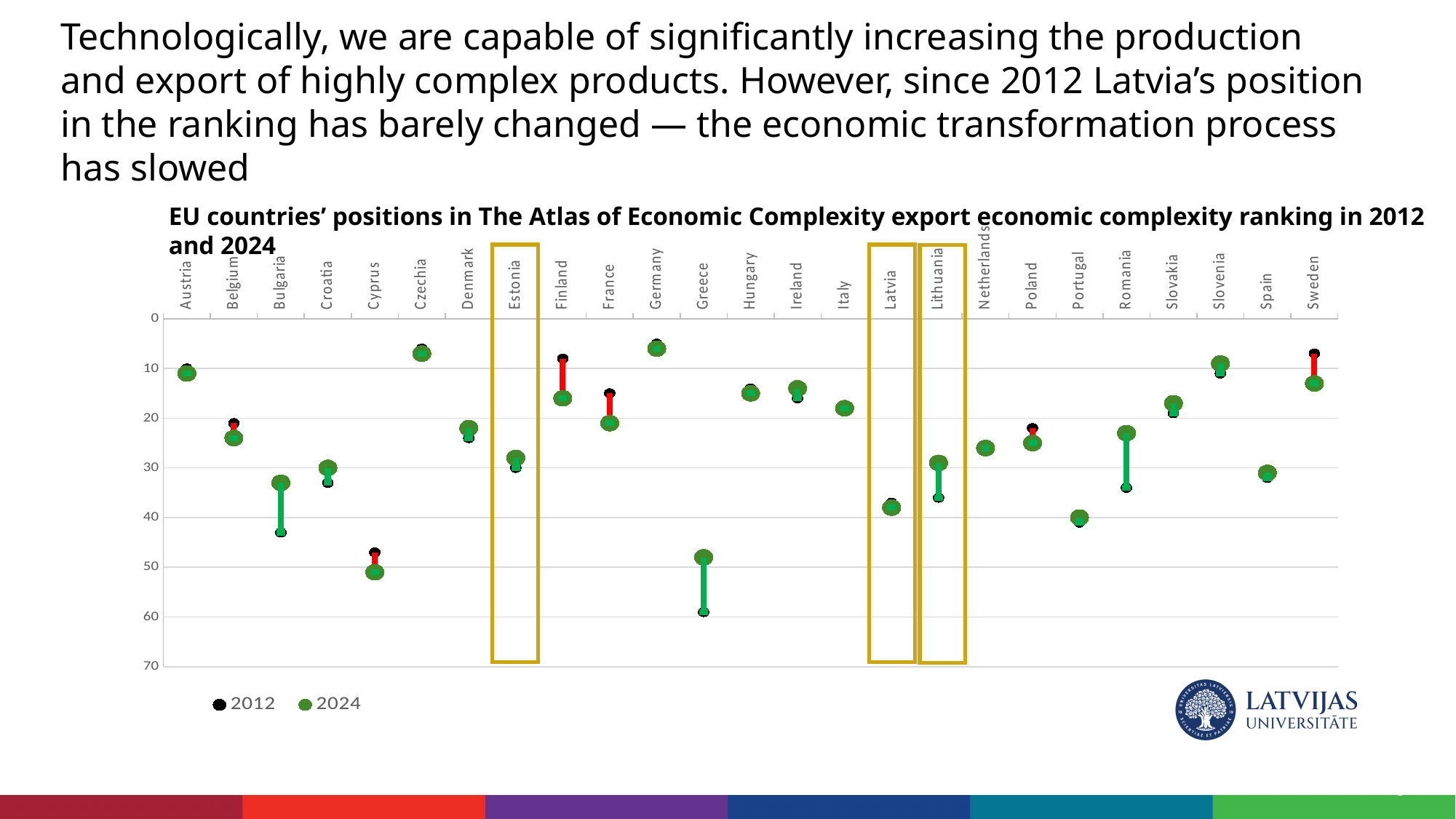
Is the 2024 value for Greece greater or less than 40? greater Which has the larger 2024 value, Latvia or Estonia? Latvia What kind of chart is this? Scatter (dot) chart How many series does the legend list? 2 Is the 2012 value for Lithuania greater or less than 30? greater Is the 2024 value for Latvia greater or less than 30? greater Which country has the highest (worst) ranking position value in 2012? Greece Which has the larger 2012 value, Greece or Bulgaria? Greece What are the two series shown in the legend? 2012 and 2024 Which three countries are highlighted with boxes on the chart? Estonia, Latvia, Lithuania How many countries are plotted on the x axis? 25